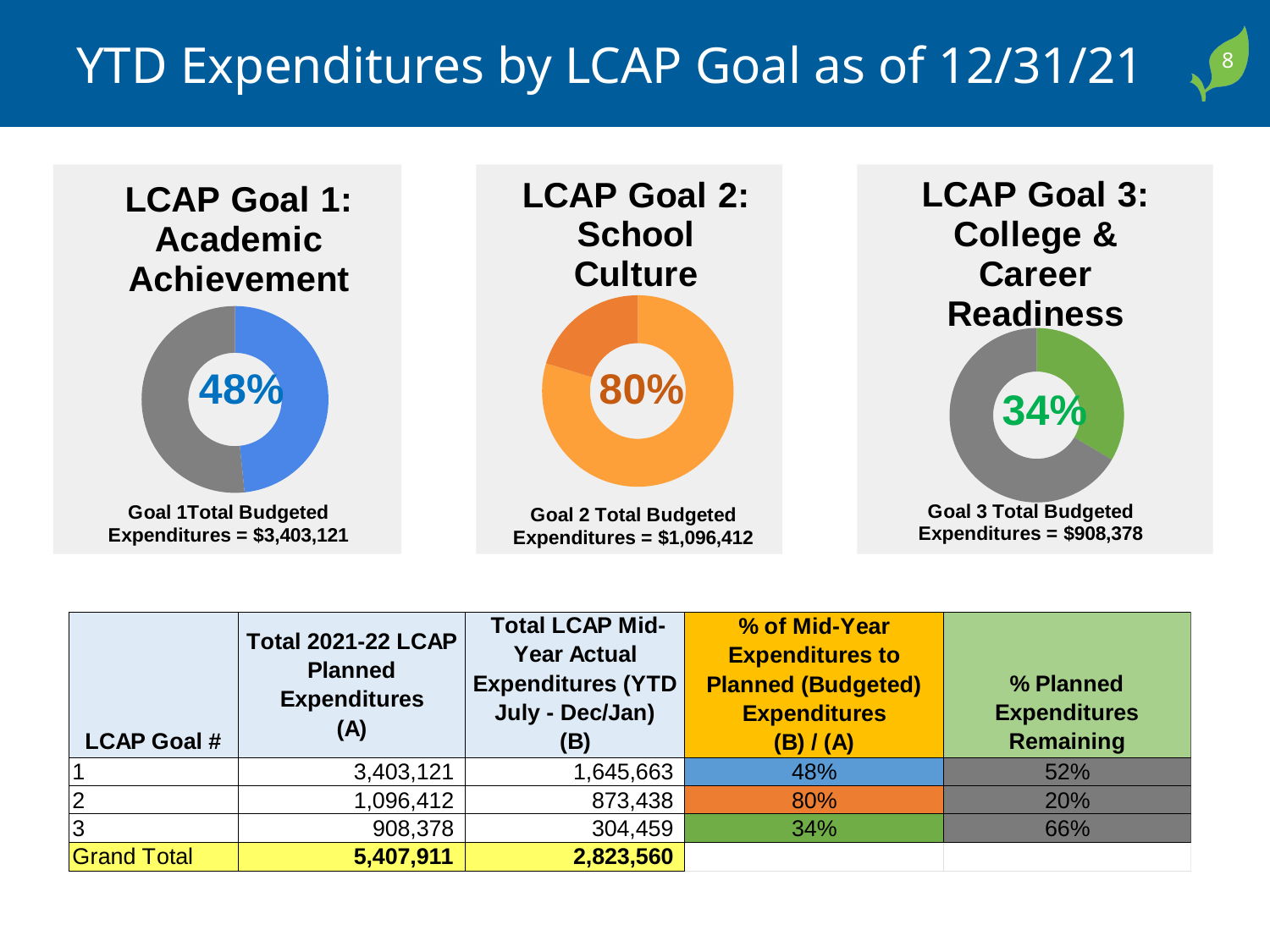
Which of the three LCAP Goal charts shows the highest percentage? LCAP Goal 2: School Culture What is the Goal 2 Total Budgeted Expenditures figure printed below the LCAP Goal 2 chart? $1,096,412 What kind of chart is used for each of the three LCAP Goals on the slide? Donut (pie) chart On the LCAP Goal 2: School Culture chart, what percentage is shown in the center of the donut? 80% On the LCAP Goal 1: Academic Achievement chart, what percentage is shown in the center of the donut? 48% On the LCAP Goal 1 chart, what share of the donut is the grey (remaining) portion? 52% What colour is the highlighted slice on the LCAP Goal 3: College & Career Readiness chart? Green On the LCAP Goal 3: College & Career Readiness chart, what percentage is shown in the center of the donut? 34% How many donut charts are shown on the slide? 3 Which of the three LCAP Goal charts shows the lowest percentage? LCAP Goal 3: College & Career Readiness What is the difference between the percentage shown on the LCAP Goal 2 chart and the percentage shown on the LCAP Goal 3 chart? 46% Is the percentage shown on the LCAP Goal 1 chart larger or smaller than the percentage shown on the LCAP Goal 2 chart? smaller